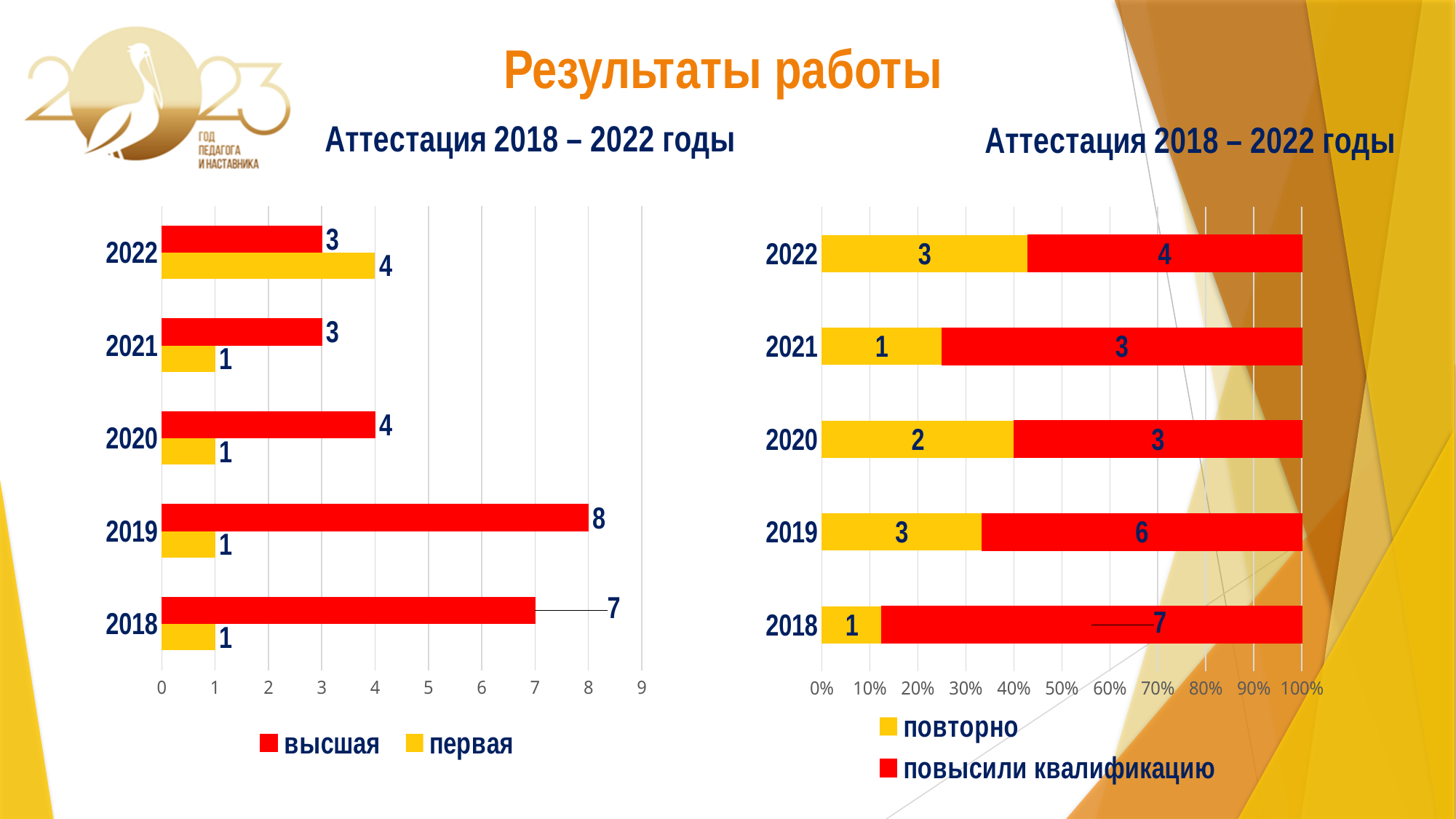
On the left chart, how many series does the legend list? 2 On the right chart, how many years are shown? 5 On the left chart, what is the value for первая in 2022? 4 What kind of chart is the right chart? stacked bar chart On the left chart, which year has the highest value for высшая? 2019 On the left chart, what is the difference between высшая and первая in 2018? 6 On the left chart, which is larger in 2022, высшая or первая? первая On the right chart, what is the total of the stacked bar for 2018? 8 On the left chart, what is the value for высшая in 2019? 8 On the left chart, which year has the highest value for первая? 2022 On the right chart, what is the value for повторно in 2020? 2 On the right chart, what is the value for повысили квалификацию in 2019? 6